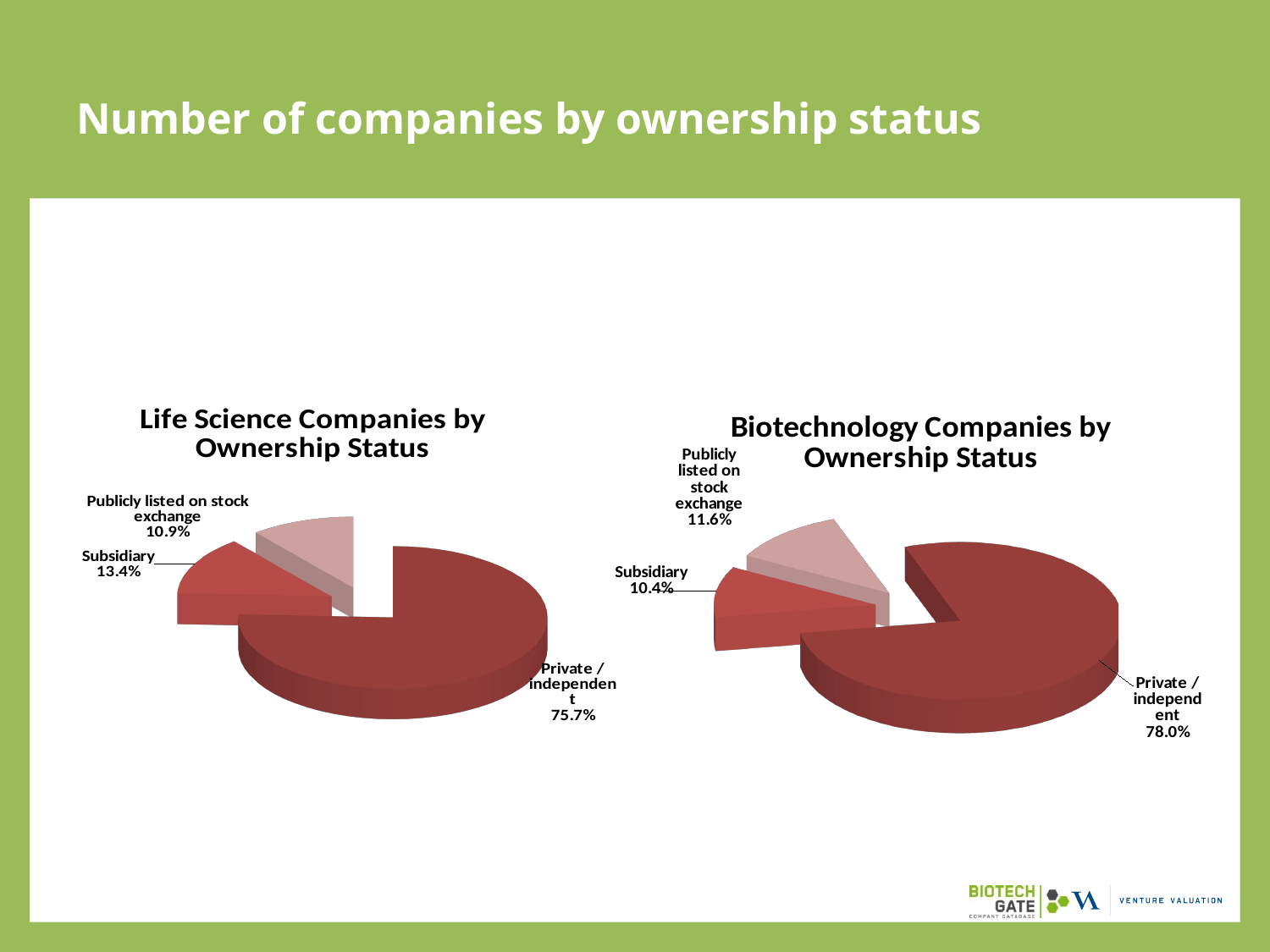
In the 'Biotechnology Companies by Ownership Status' chart, which category has the smallest share? Subsidiary In the 'Life Science Companies by Ownership Status' chart, what is the difference between the Subsidiary share and the Publicly listed on stock exchange share? 2.5% How many slices does the 'Life Science Companies by Ownership Status' chart have? 3 In the 'Life Science Companies by Ownership Status' chart, which category has the smallest share? Publicly listed on stock exchange What is the title of the chart on the left of the slide? Life Science Companies by Ownership Status In the 'Biotechnology Companies by Ownership Status' chart, which is larger: Subsidiary or Publicly listed on stock exchange? Publicly listed on stock exchange In the 'Biotechnology Companies by Ownership Status' chart, what share is Publicly listed on stock exchange? 11.6% In the 'Life Science Companies by Ownership Status' chart, what share is Subsidiary? 13.4% In the 'Biotechnology Companies by Ownership Status' chart, what share is Private / independent? 78.0% In the 'Biotechnology Companies by Ownership Status' chart, which category has the largest share? Private / independent In the 'Life Science Companies by Ownership Status' chart, what share is Private / independent? 75.7% What type of chart is the 'Biotechnology Companies by Ownership Status' chart? Pie chart